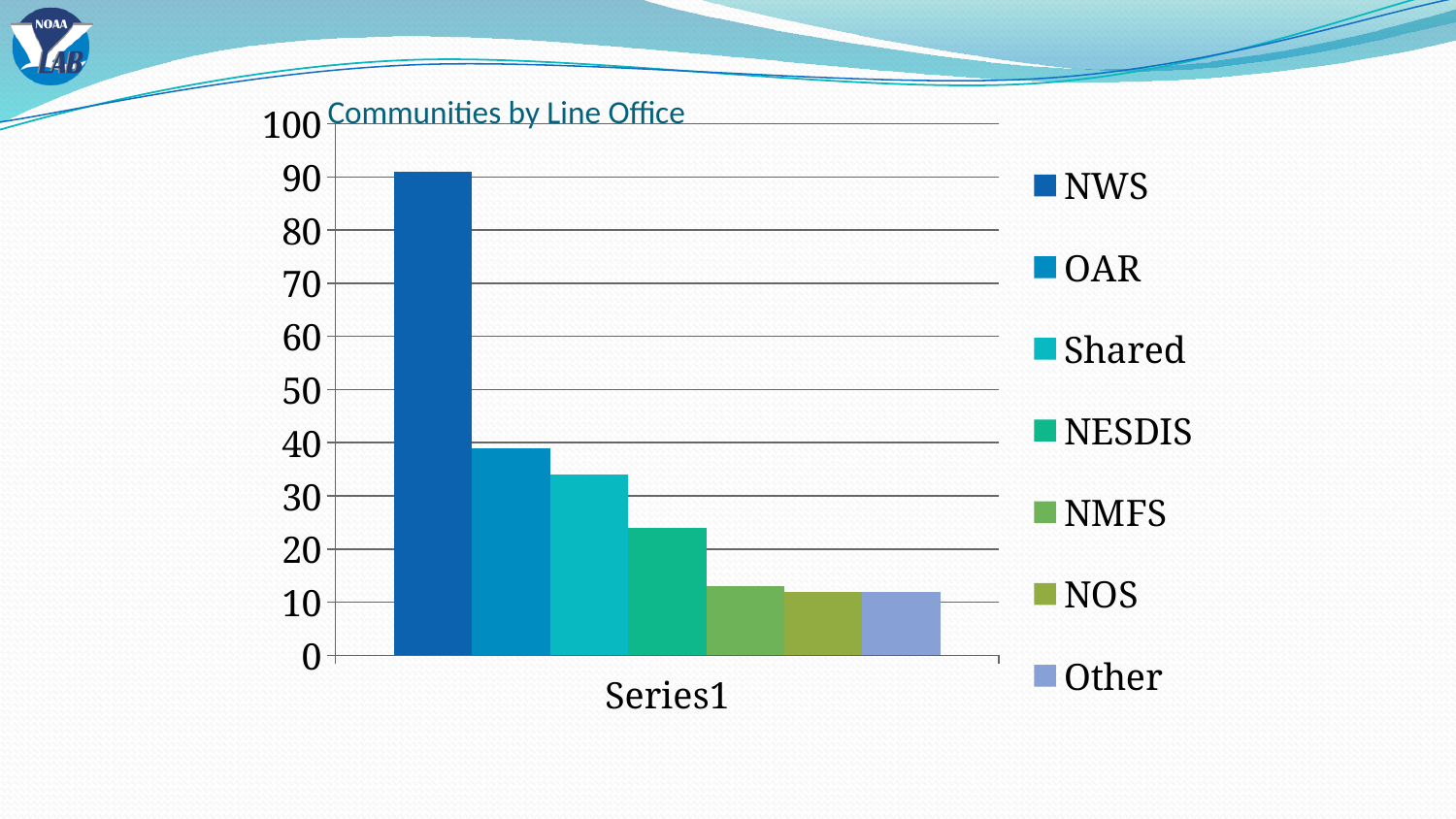
Is the value for OAR greater or less than 30? greater Is the value for NESDIS greater or less than 30? less What is the title of the chart? Communities by Line Office Which is larger, the value for NESDIS or the value for NMFS? NESDIS Is the value for NWS greater or less than 80? greater How many bars are plotted in the chart? 7 How many entries does the chart's legend list? 7 What kind of chart is shown on the slide? bar chart Which line office has the highest bar? NWS Which is larger, the value for OAR or the value for Shared? OAR